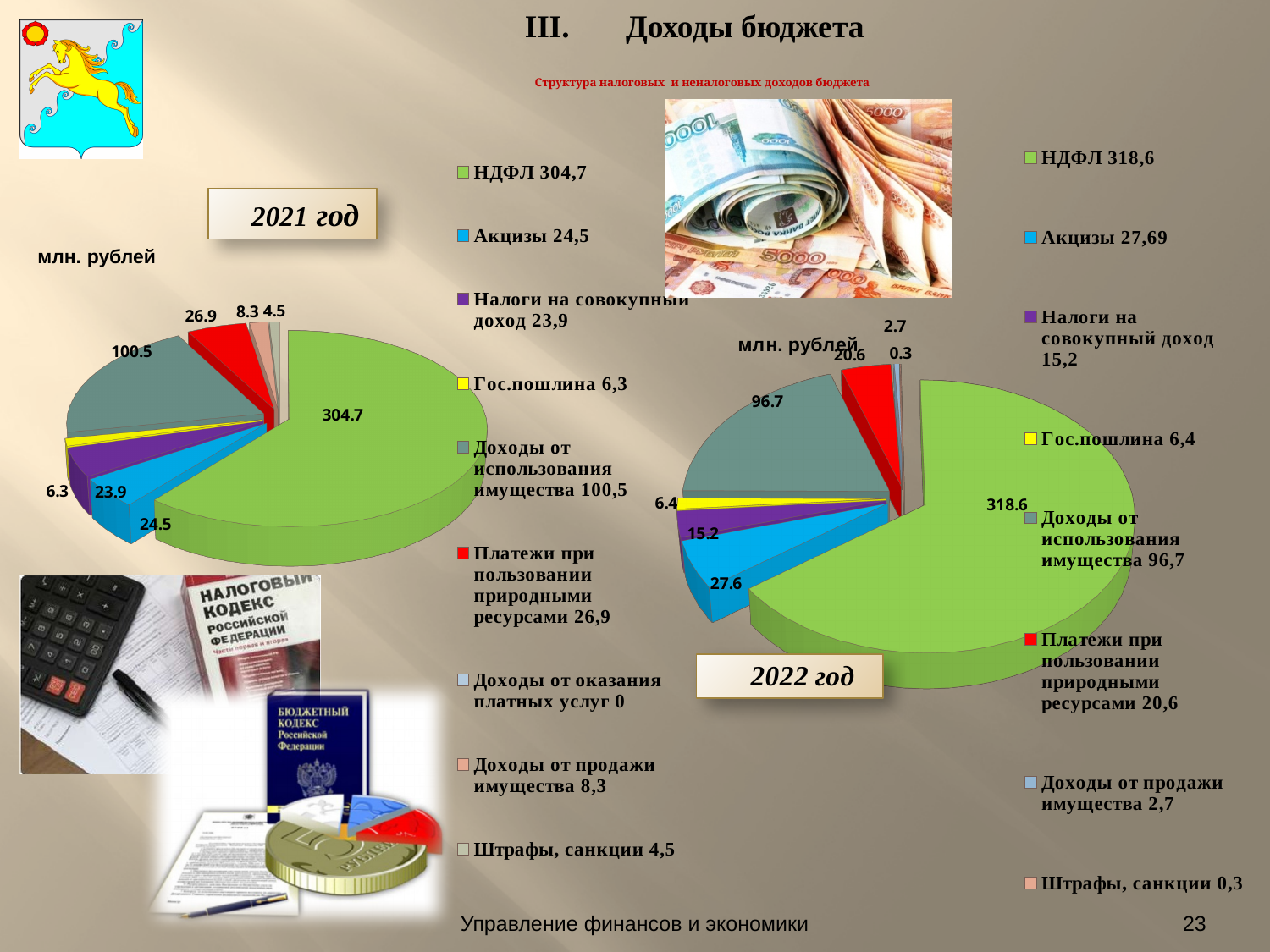
In the 2022 год pie chart, what is the difference between НДФЛ and Доходы от использования имущества? 221.9 In the 2022 год pie chart, what is the value for Доходы от использования имущества? 96.7 In the 2021 год pie chart, which category has the largest value? НДФЛ What type of chart is used for the 2021 год data? Pie chart In the 2022 год pie chart, which category has the smallest value? Штрафы, санкции In what units are the values on both charts given? млн. рублей How many categories does the legend of the 2022 год pie chart list? 8 In the 2022 год pie chart, what is the value for Штрафы, санкции? 0.3 In the 2022 год pie chart, which is larger: Акцизы or Платежи при пользовании природными ресурсами? Акцизы In the 2021 год pie chart, what is the difference between НДФЛ and Доходы от использования имущества? 204.2 In the 2021 год pie chart, what is the value for НДФЛ? 304.7 In the 2021 год pie chart, what is the value for Гос.пошлина? 6.3